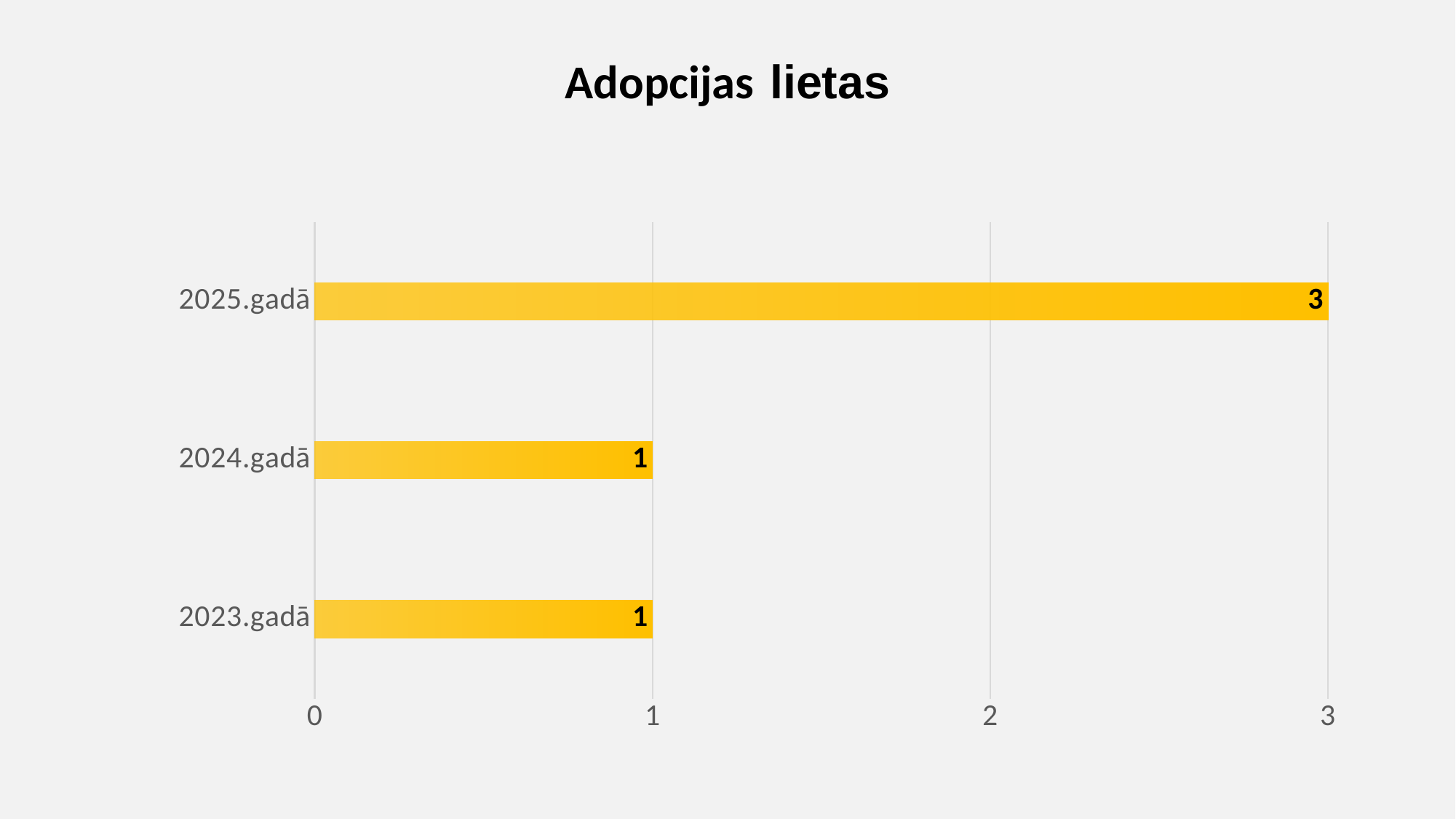
What kind of chart is shown on the slide? bar chart How many categories are shown in the chart? 3 What is the difference between the values for 2025.gadā and 2024.gadā? 2 What is the title of the chart? Adopcijas lietas What is the value for 2025.gadā? 3 Is the value for 2025.gadā greater or less than 2? greater Which category has the highest value? 2025.gadā What is the value for 2024.gadā? 1 What is the value for 2023.gadā? 1 What is the highest value shown on the horizontal axis? 3 Is the value for 2024.gadā greater or less than 2? less Which is larger, the value for 2025.gadā or the value for 2023.gadā? 2025.gadā